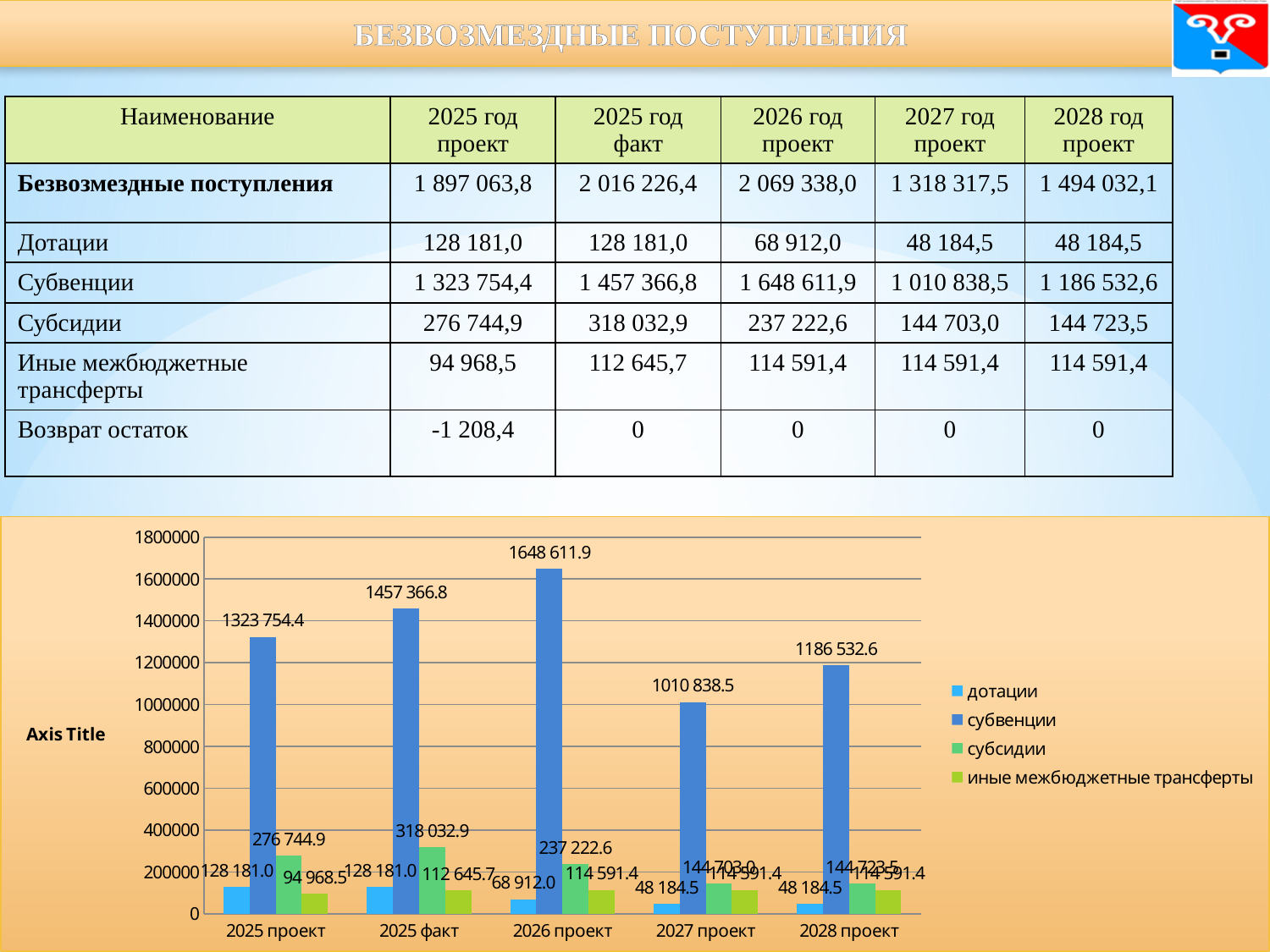
What is the value of дотации for 2026 проект in the chart? 68 912.0 What kind of chart is shown at the bottom of the slide? bar chart What is the label shown on the vertical axis of the chart? Axis Title How many categories are shown along the x axis of the chart? 5 How many series does the chart's legend list? 4 Which category has the lowest value for субвенции in the chart? 2027 проект Is the value of субвенции for 2028 проект greater or less than 1000000? greater What is the value of субвенции for 2026 проект in the chart? 1648 611.9 Which is larger in the chart: субсидии for 2025 проект or субсидии for 2026 проект? 2025 проект Which category has the highest value for субвенции in the chart? 2026 проект By how much does субвенции for 2025 факт exceed субвенции for 2025 проект in the chart? 133 612.4 What is the value of субсидии for 2025 факт in the chart? 318 032.9